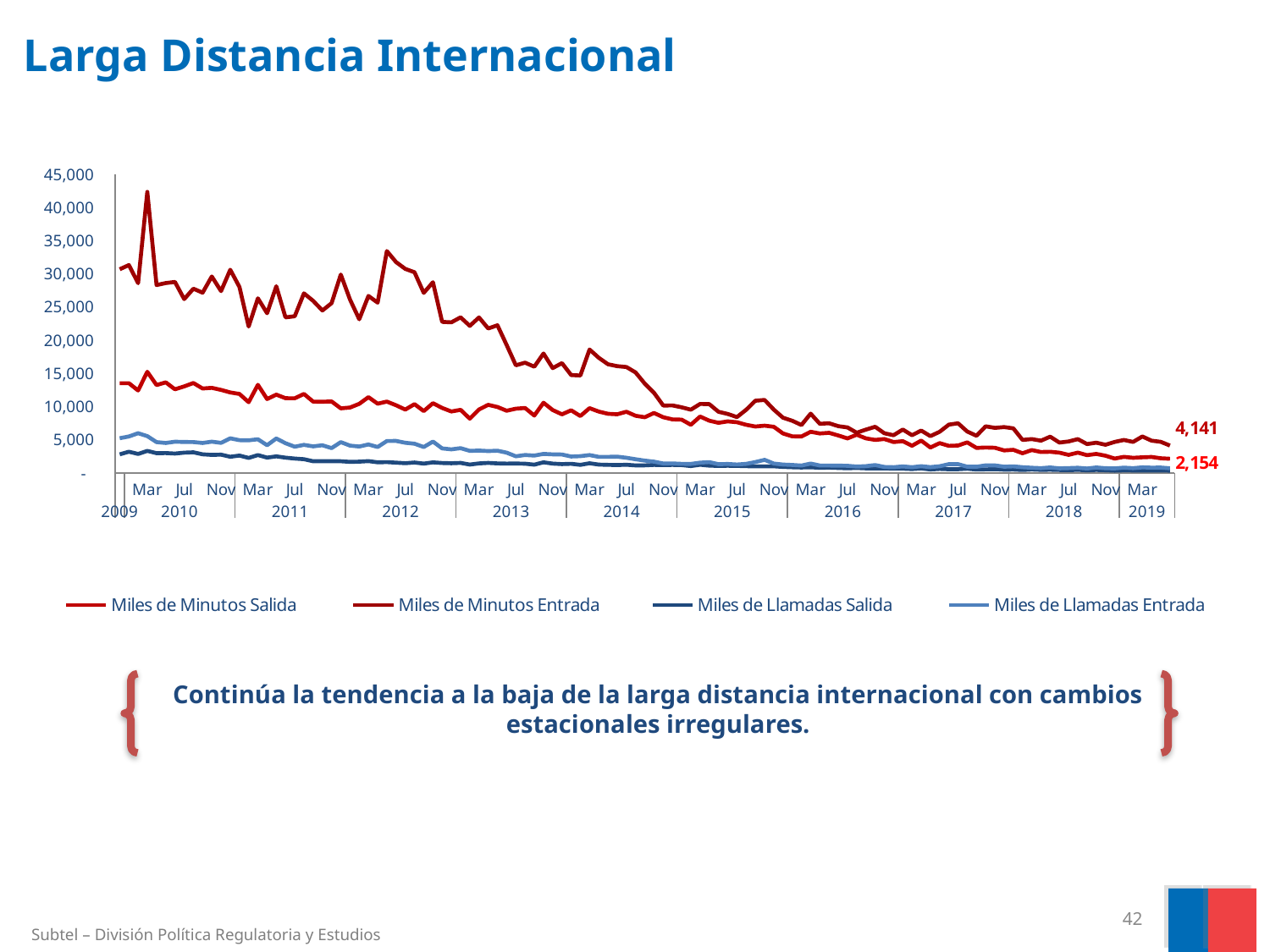
What is the highest value shown on the y axis of the chart? 45,000 How many years are labelled along the x axis of the chart? 11 What is the difference between the two data labels shown at the right end of the chart, 4,141 and 2,154? 1,987 Which of the two labelled end values is larger, 4,141 or 2,154? 4,141 What is the lower of the two data labels shown at the right end of the chart? 2,154 What is the data label shown at the end of the topmost line in the chart? 4,141 Is the value of Miles de Llamadas Entrada in 2009 greater or less than 10,000? less What type of chart is shown on the slide? line chart What is the first series listed in the chart legend? Miles de Minutos Salida How many series does the chart legend list? 4 Overall, do the values in the chart rise or fall from 2009 to 2019? fall